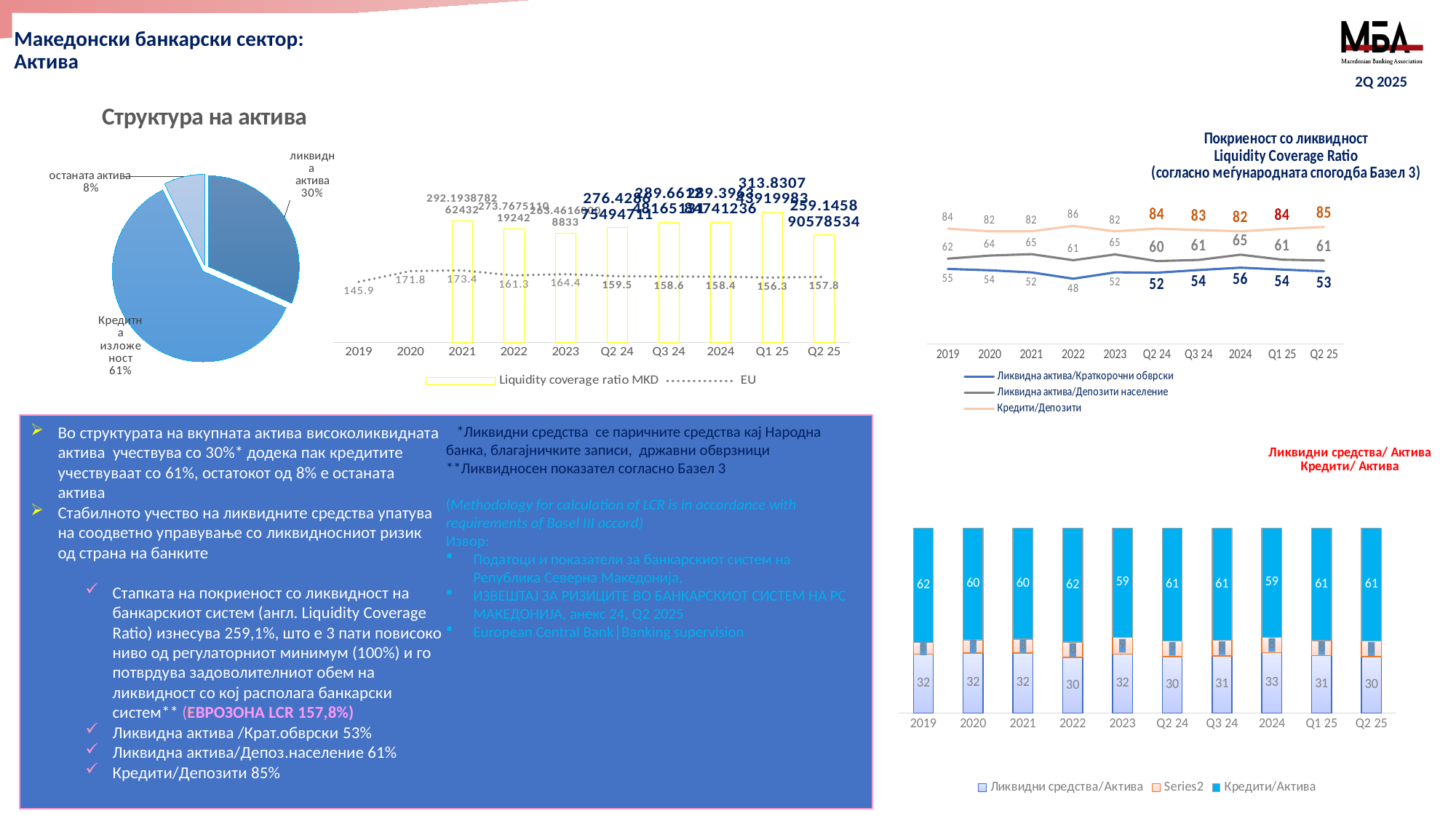
In the Liquidity coverage ratio chart (top middle), what is the EU value for Q2 25? 157.8 In the stacked bar chart 'Ликвидни средства/ Актива Кредити/ Актива', what is the difference between 'Кредити/Актива' and 'Ликвидни средства/Актива' for 2019? 30 In the pie chart 'Структура на актива', what share is shown for 'Кредитна изложеност'? 61% In the pie chart 'Структура на актива', how many slices are there? 3 In the stacked bar chart 'Ликвидни средства/ Актива Кредити/ Актива', what is the value of 'Кредити/Актива' for 2023? 59 In the pie chart 'Структура на актива', which slice is the largest? Кредитна изложеност In the Liquidity coverage ratio chart (top middle), what is the EU value for 2019? 145.9 In the Liquidity coverage ratio chart (top middle), which period has the highest EU value? 2021 In the line chart 'Покриеност со ликвидност', what is the value of 'Ликвидна актива/Краткорочни обврски' for 2022? 48 In the line chart 'Покриеност со ликвидност', what is the value of 'Кредити/Депозити' for Q2 25? 85 In the line chart 'Покриеност со ликвидност', how many series does the legend list? 3 In the pie chart 'Структура на актива', what share is shown for 'останата актива'? 8%